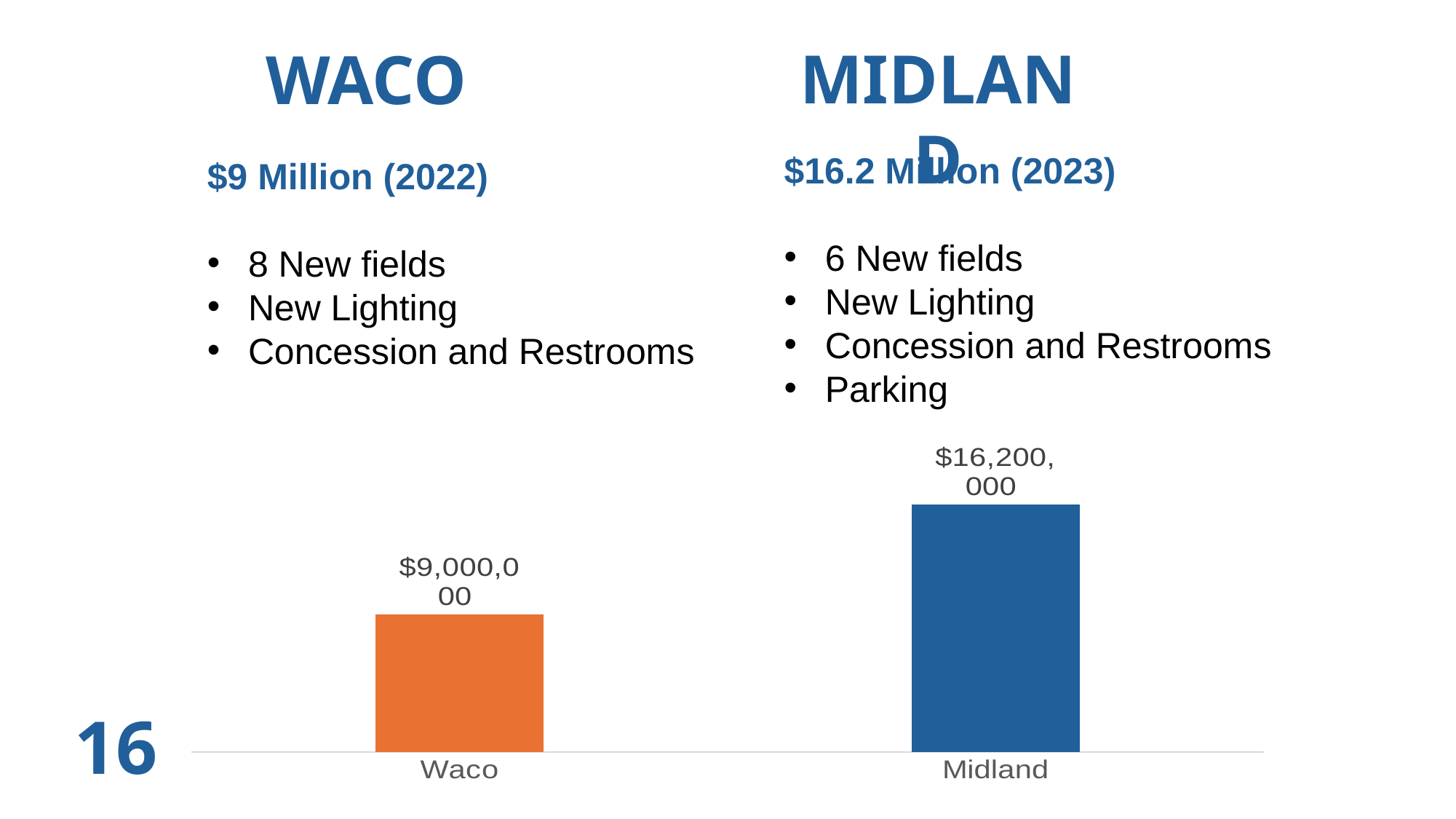
What colour is the bar for Midland? Blue What kind of chart is shown on the slide? Bar chart Do the values rise or fall from Waco to Midland along the x axis? Rise Which is larger, the value for Waco or the value for Midland? Midland What is the value of the bar for Midland? $16,200,000 Which category has the lowest bar? Waco Which category has the highest bar? Midland What colour is the bar for Waco? Orange How many categories are shown in the chart? 2 What is the value of the bar for Waco? $9,000,000 What is the difference between the Midland and Waco values? $7,200,000